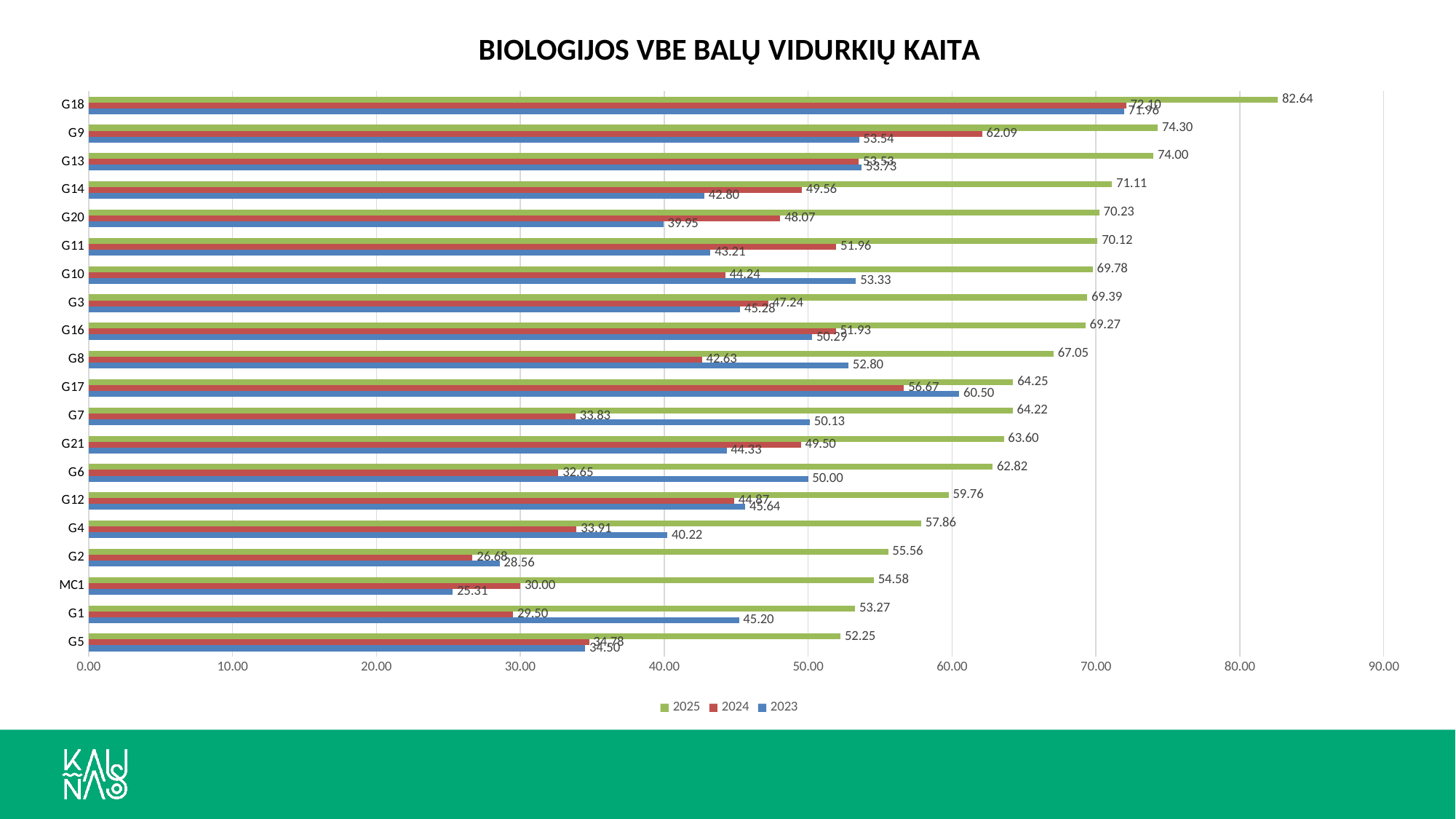
Which category has the lowest 2025 value? G5 What is the 2025 value for G14? 71.11 What is the difference between the 2025 and 2023 values for G6? 12.82 How many categories are plotted on the chart? 20 What is the title of the chart? BIOLOGIJOS VBE BALŲ VIDURKIŲ KAITA What is the 2023 value for G17? 60.50 What is the 2024 value for G7? 33.83 What kind of chart is shown on the slide? bar chart For G10, which is larger: the 2024 value or the 2023 value? 2023 How many series does the legend list? 3 Which category has the highest 2025 value? G18 What is the 2023 value for MC1? 25.31